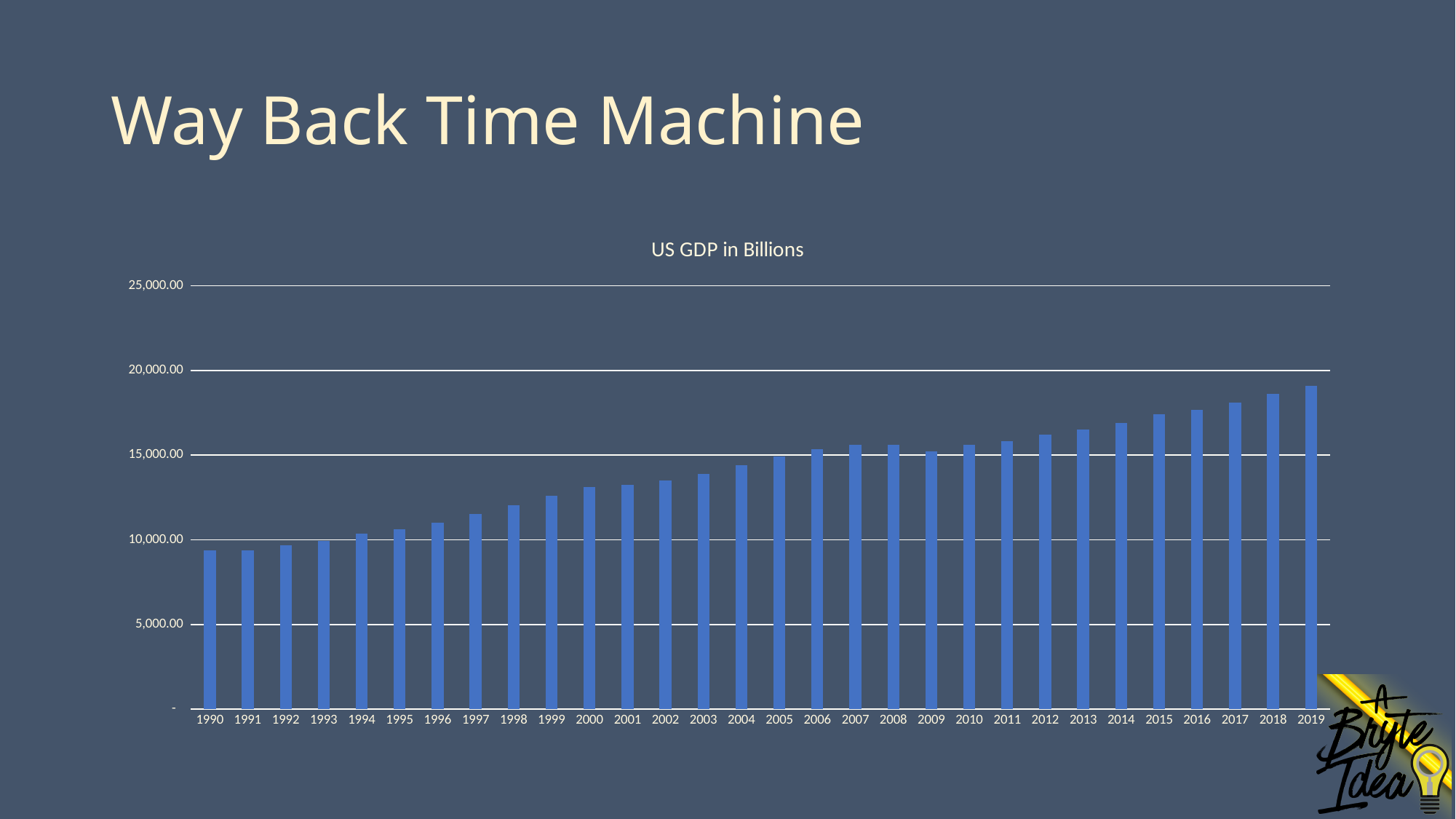
What is the highest value shown on the vertical axis? 25,000.00 What kind of chart is shown on the slide? bar chart How many years (bars) are plotted in the chart? 30 Is the value for 2012 greater or less than 15,000.00? greater Is the value for 2019 greater or less than 20,000.00? less Is the value for 2007 greater or less than 15,000.00? greater What is the title of the chart? US GDP in Billions Which year has the highest US GDP value in the chart? 2019 Do the values generally rise or fall from 1990 to 2019? rise Which year has the larger value, 2010 or 2000? 2010